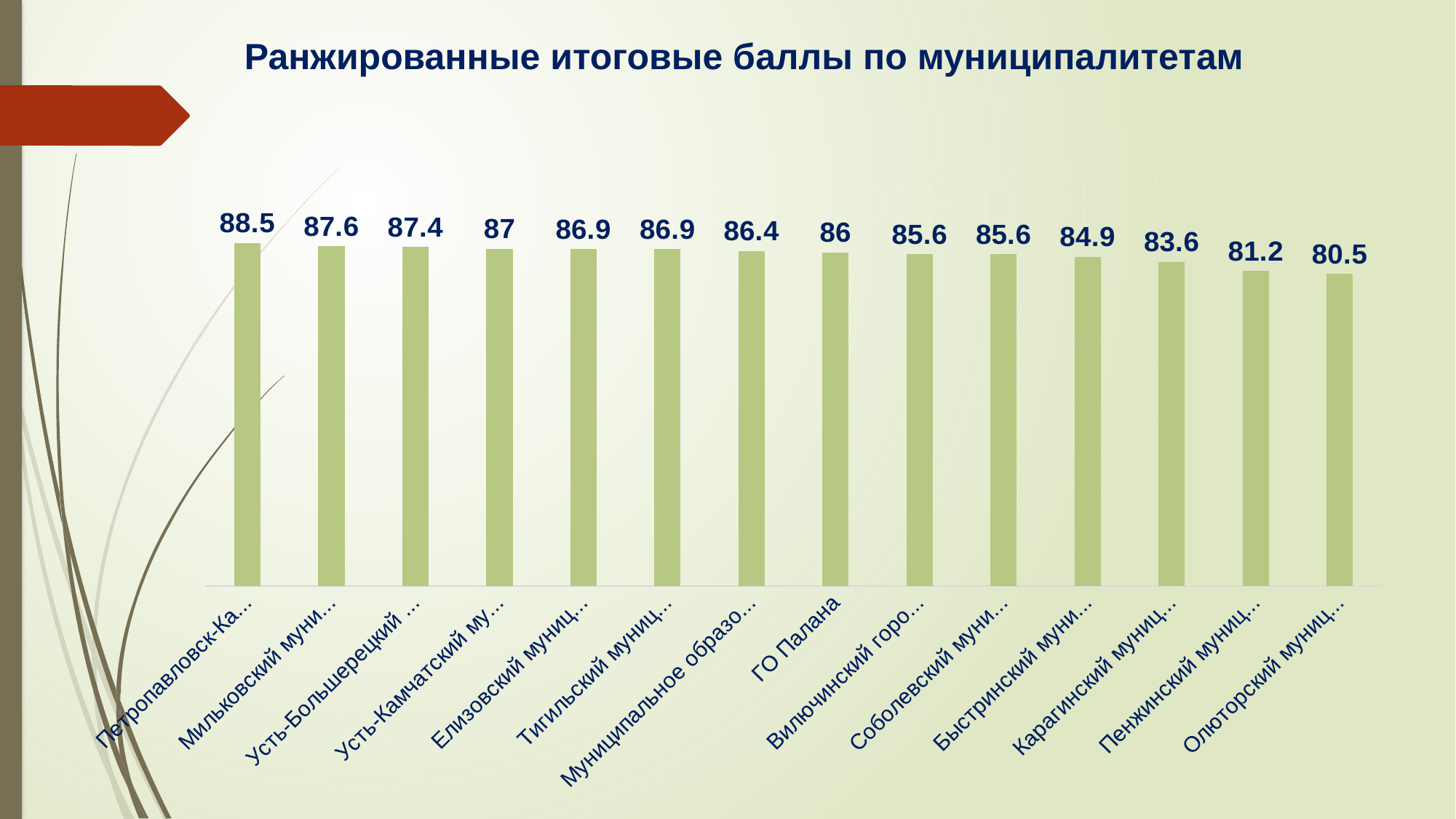
What is the value for the Пенжинский municipality bar? 81.2 What type of chart is shown on the slide? bar chart What is the value for the Карагинский municipality bar? 83.6 Which bar has the highest value? Петропавловск-Ка… (88.5) What is the title of the chart? Ранжированные итоговые баллы по муниципалитетам How many bars (municipalities) are shown in the chart? 14 What is the difference between the highest value (88.5) and the lowest value (80.5)? 8 Which bar has the lowest value? Олюторский муниц… (80.5) Which is larger: the value for ГО Палана or the value for the Быстринский municipality? ГО Палана Do the values rise or fall from left to right along the x axis? fall What is the value for ГО Палана? 86 What is the value for the Елизовский municipality bar? 86.9